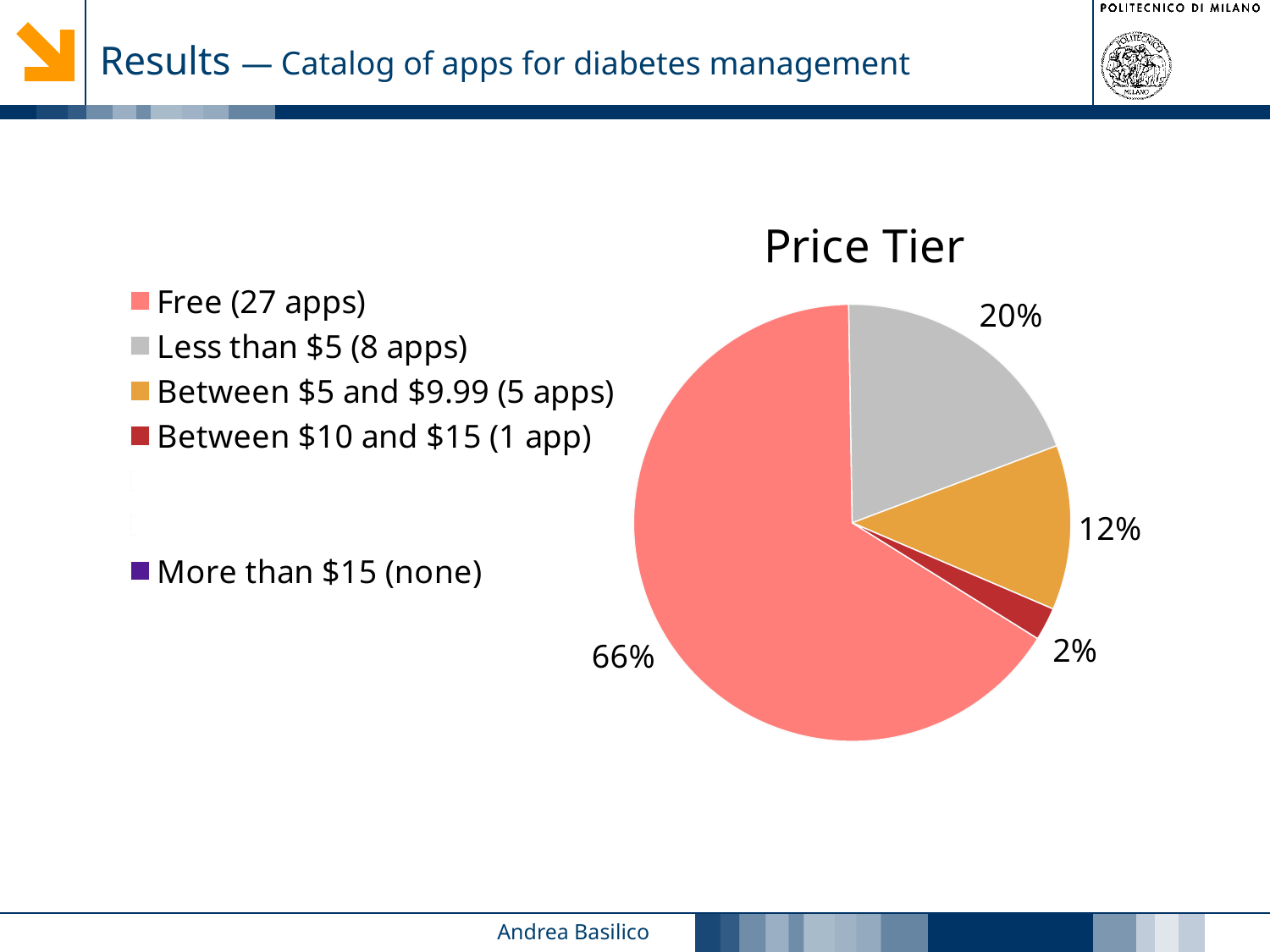
What kind of chart is shown on the slide? pie chart What share of the pie is the Free slice? 66% What is the difference in percentage points between the Free slice and the Less than $5 slice? 46 Which slice is larger: Less than $5 or Between $5 and $9.99? Less than $5 What share of the pie is the Less than $5 slice? 20% Which category has the largest slice of the pie? Free What is the title of the chart? Price Tier What share of the pie is the Between $5 and $9.99 slice? 12% According to the legend, how many apps are in the Free category? 27 apps Which plotted category has the smallest slice of the pie? Between $10 and $15 How many slices with percentage labels are shown in the pie? 4